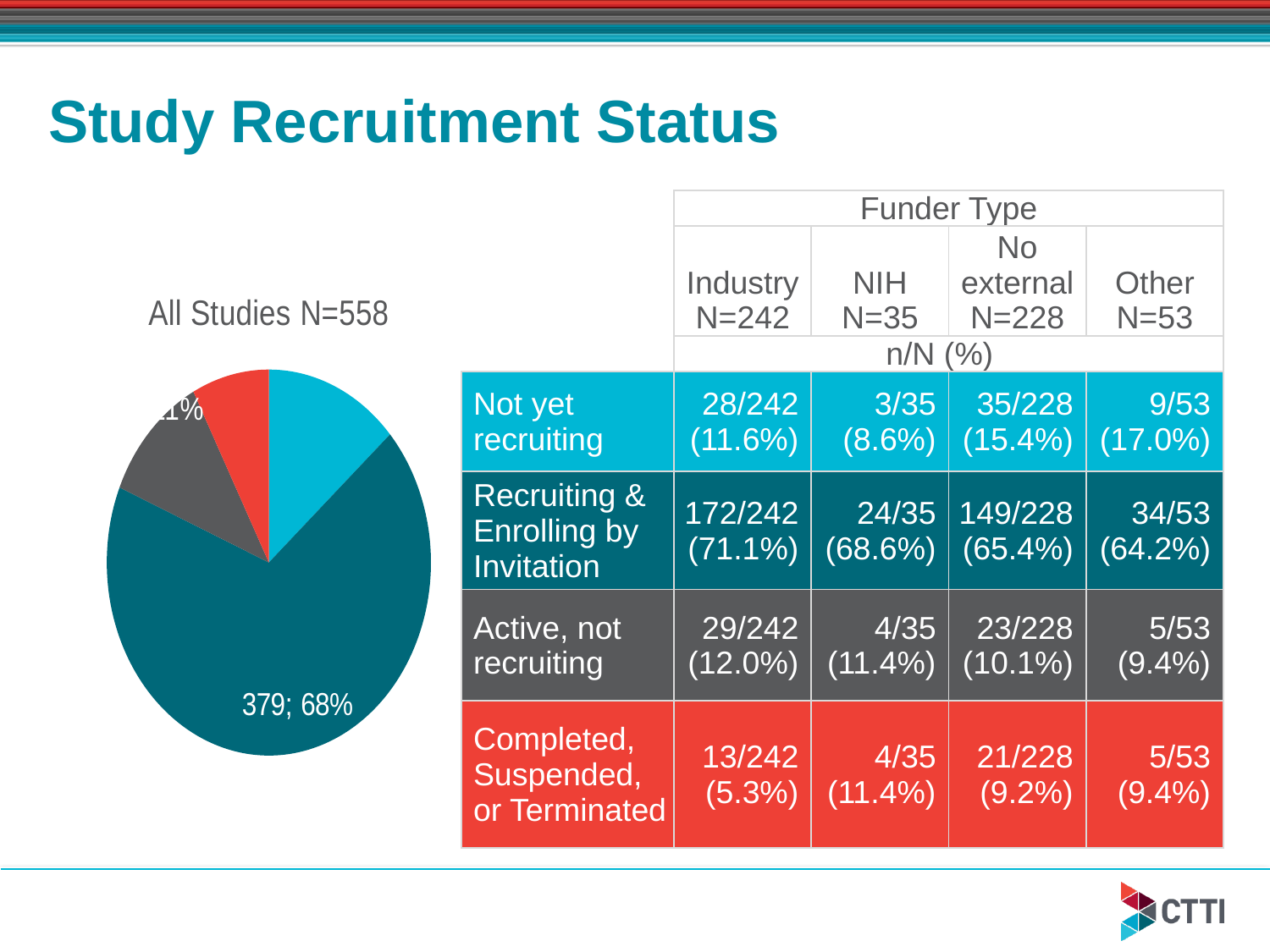
Which colour is the largest slice of the pie chart? dark teal How many studies are in the largest slice of the pie chart? 379 Is the dark teal slice or the red slice of the pie chart larger? the dark teal slice What data label is printed on the largest slice of the pie chart? 379; 68% Is the largest slice of the pie chart greater or less than 50% of the pie? greater What is the title of the pie chart? All Studies N=558 How many slices does the pie chart have? 4 Which slice of the pie chart is the smallest? the red slice What kind of chart is shown on the slide? pie chart What share of the pie does the largest slice represent? 68% What is the total number of studies represented by the pie chart? 558